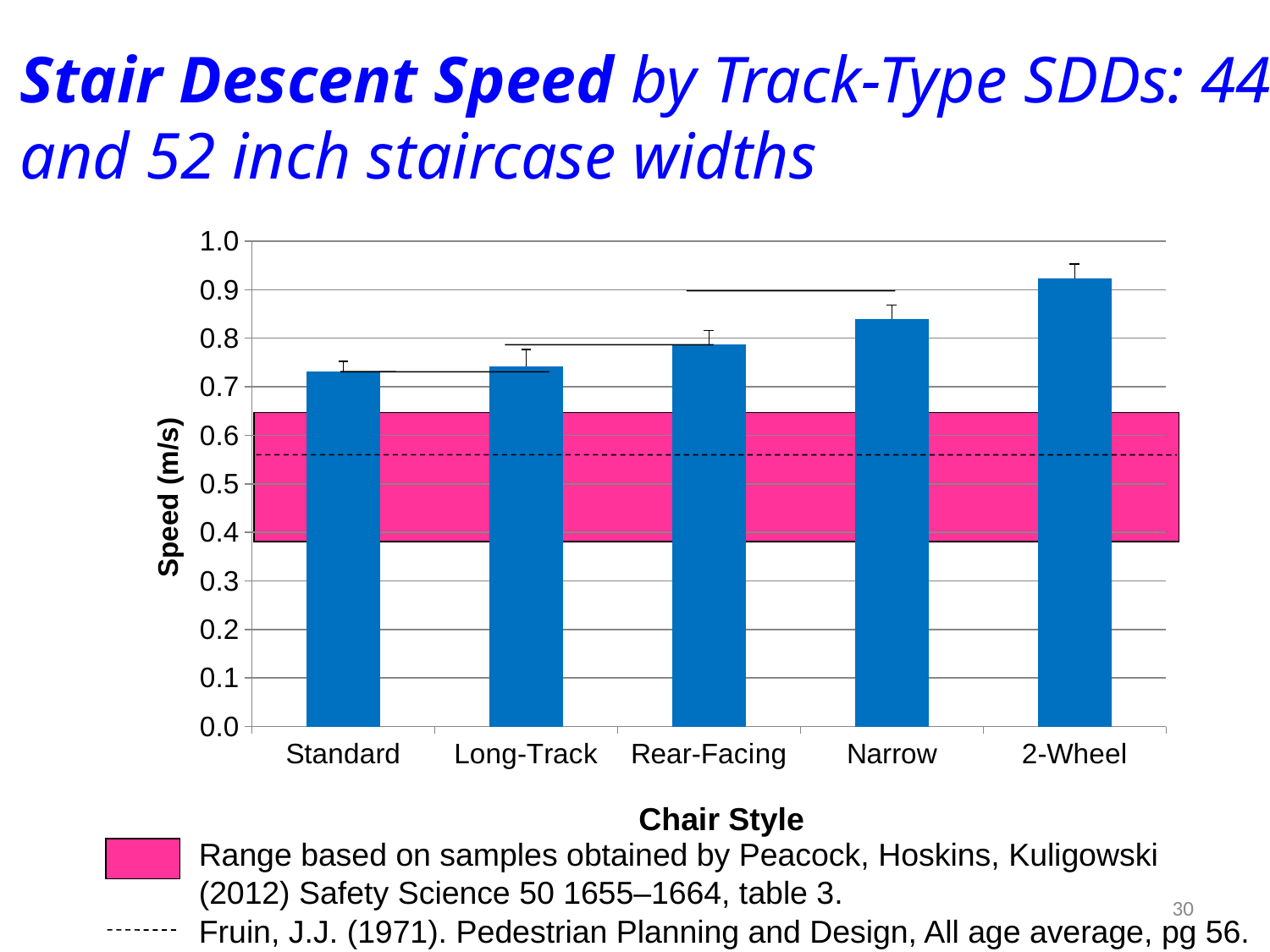
Is the speed for 2-Wheel greater or less than 0.9? greater Is the speed for Standard greater or less than 0.7? greater Which has a higher speed, 2-Wheel or Narrow? 2-Wheel Is the speed for Narrow greater or less than 0.9? less What kind of chart is shown on the slide? bar chart Which has a higher speed, Narrow or Rear-Facing? Narrow Do the bar values rise or fall from left to right across the chair styles? rise Which chair style has the highest stair descent speed? 2-Wheel What is the label of the y axis? Speed (m/s) How many chair styles are shown on the x axis? 5